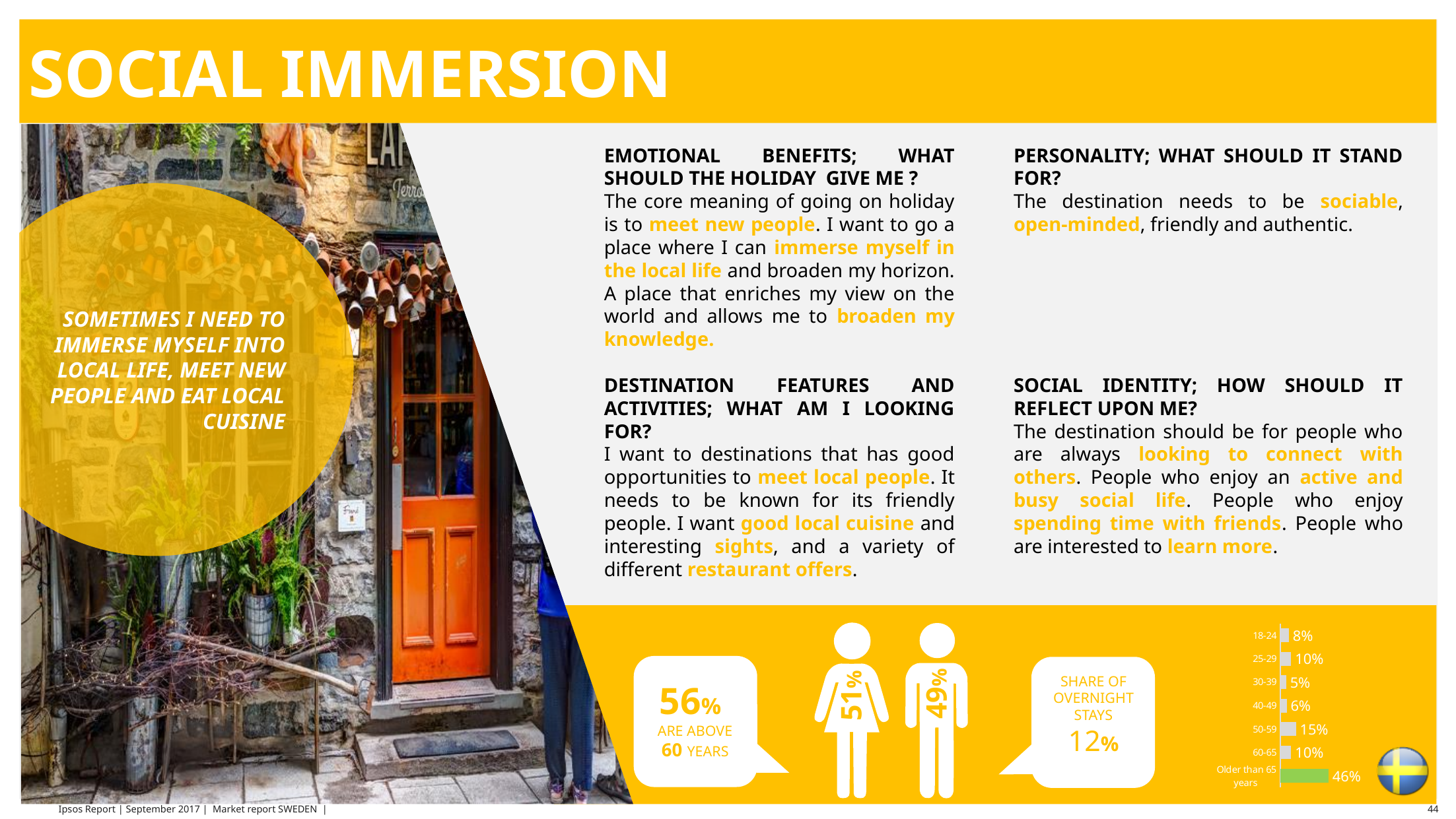
In the age-group bar chart at the bottom right, what is the value for 30-39? 5% In the age-group bar chart at the bottom right, what is the value for Older than 65 years? 46% In the age-group bar chart at the bottom right, which bar is coloured green rather than grey? Older than 65 years In the age-group bar chart at the bottom right, which age group has the lowest value? 30-39 In the age-group bar chart at the bottom right, what is the value for 50-59? 15% What kind of chart is shown at the bottom right of the slide? Bar chart In the age-group bar chart at the bottom right, which age group has the highest value? Older than 65 years How many age groups are shown in the bar chart at the bottom right? 7 In the age-group bar chart at the bottom right, what is the value for 18-24? 8% In the age-group bar chart at the bottom right, what is the difference between the values for Older than 65 years and 50-59? 31% In the age-group bar chart at the bottom right, what is the difference between the values for 25-29 and 40-49? 4% In the age-group bar chart at the bottom right, which is larger, the value for 50-59 or the value for 60-65? 50-59